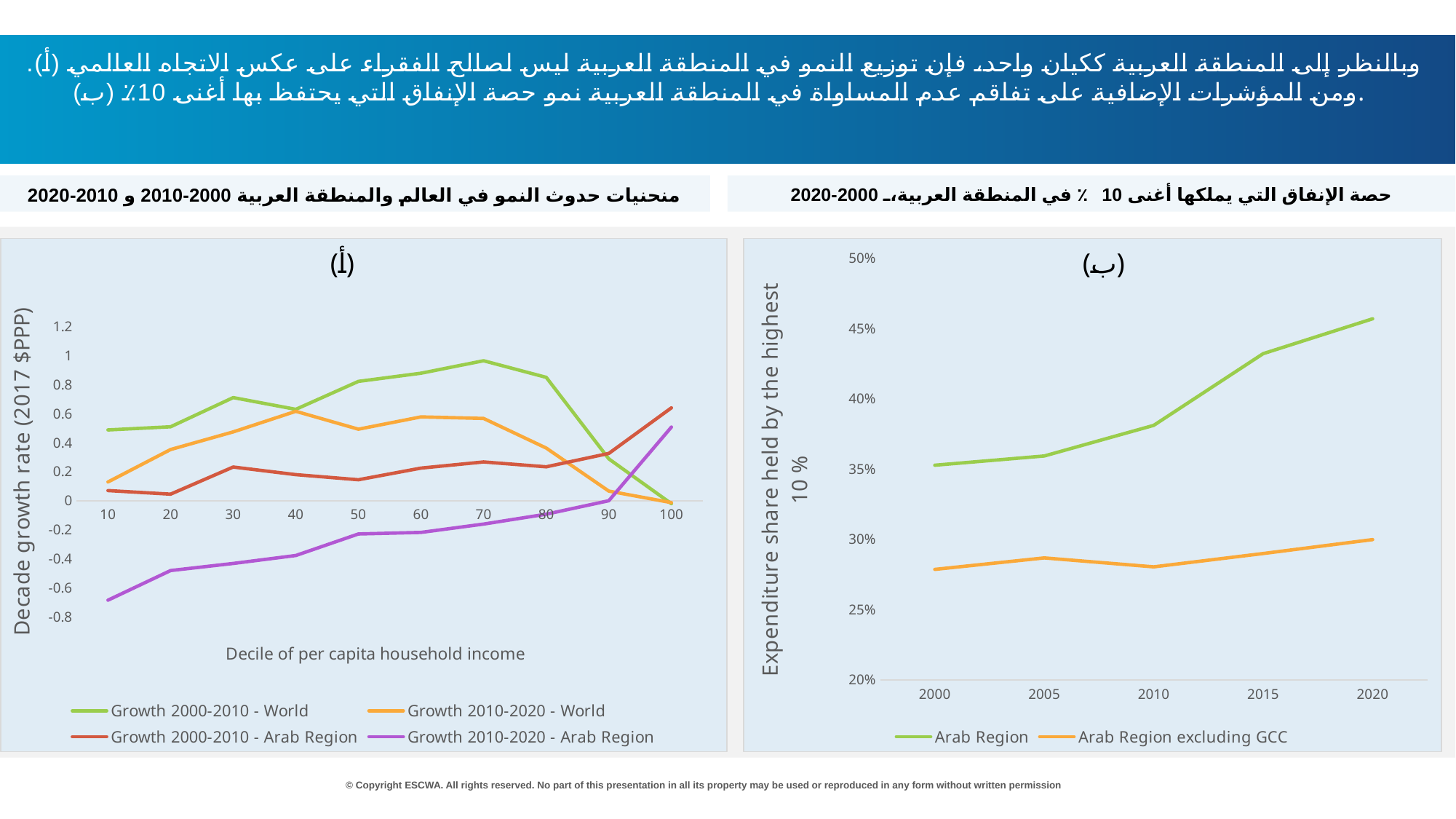
In the left chart (أ), which is larger at decile 100: Growth 2000-2010 - Arab Region or Growth 2010-2020 - World? Growth 2000-2010 - Arab Region In the left chart (أ), at which decile does the Growth 2000-2010 - World series reach its highest value? 70 In the right chart (ب), is the value for Arab Region in 2020 greater or less than 40%? greater In the right chart (ب), which series is higher in 2010: Arab Region or Arab Region excluding GCC? Arab Region In the left chart (أ), does the Growth 2010-2020 - Arab Region series rise or fall from decile 10 to decile 100? rise How many series does the legend of the right chart (ب) list? 2 In the right chart (ب), in which year does the Arab Region series reach its highest value? 2020 How many decile points are plotted along the x axis of the left chart (أ)? 10 How many series does the legend of the left chart (أ) list? 4 In the left chart (أ), is the value for Growth 2010-2020 - Arab Region at decile 10 greater or less than -0.4? less What kind of chart is the left chart (أ)? line chart In the left chart (أ), is the value for Growth 2000-2010 - World at decile 70 greater or less than 0.8? greater